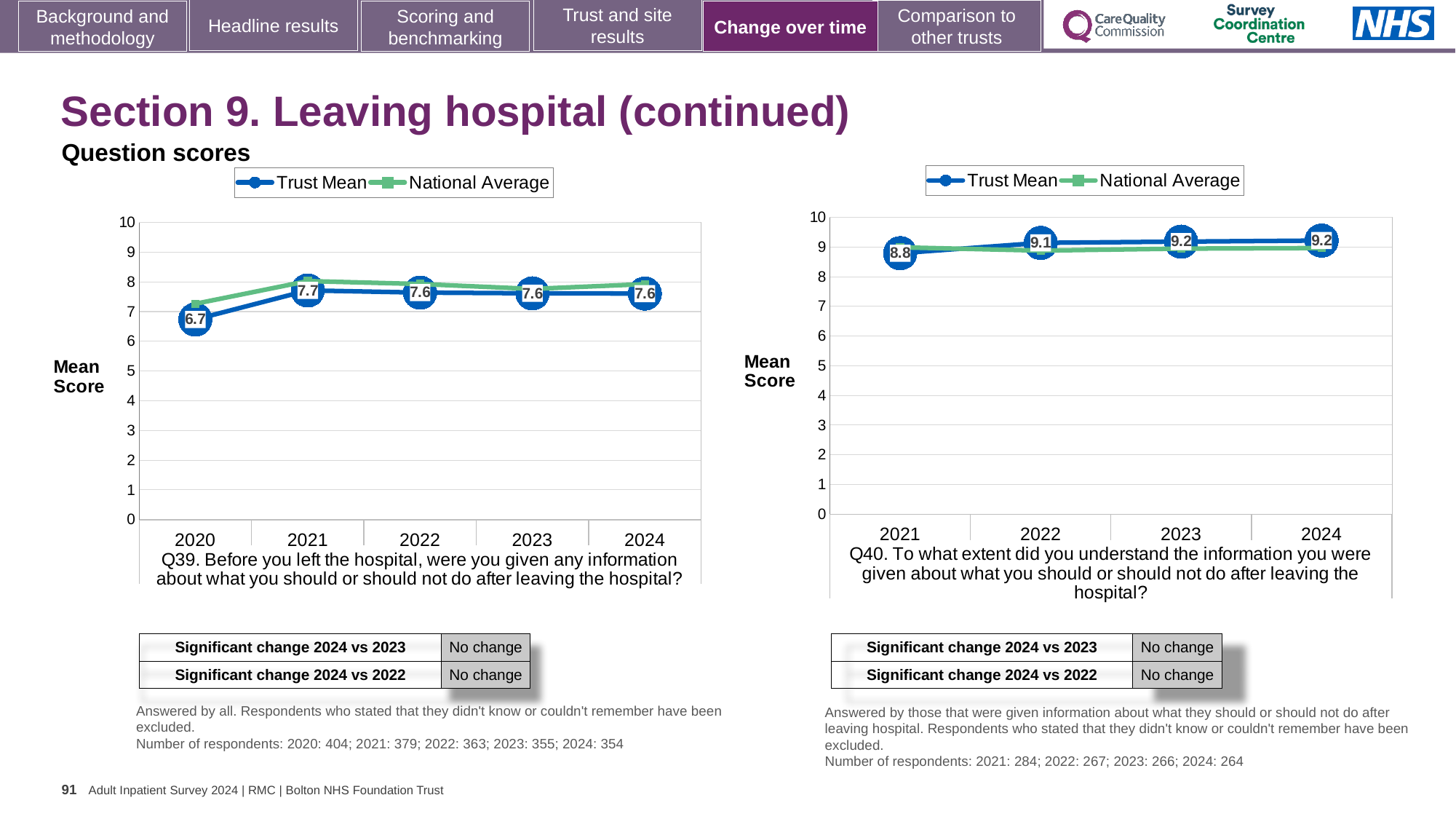
On the Q40 chart (right), does the Trust Mean rise or fall from 2021 to 2024? rise On the Q39 chart (left), what is the Trust Mean score for 2021? 7.7 On the Q40 chart (right), which year has the lowest Trust Mean score? 2021 On the Q39 chart (left), is the National Average for 2020 greater or less than 8? less On the Q39 chart (left), what is the Trust Mean score for 2020? 6.7 How many series does the legend of the Q40 chart (right) list? 2 On the Q39 chart (left), what is the difference between the Trust Mean scores for 2021 and 2020? 1.0 What kind of chart is the Q39 chart (left)? line chart On the Q39 chart (left), how many years are plotted on the x axis? 5 On the Q40 chart (right), what is the Trust Mean score for 2021? 8.8 On the Q39 chart (left), which year has the lowest Trust Mean score? 2020 On the Q40 chart (right), what is the Trust Mean score for 2024? 9.2